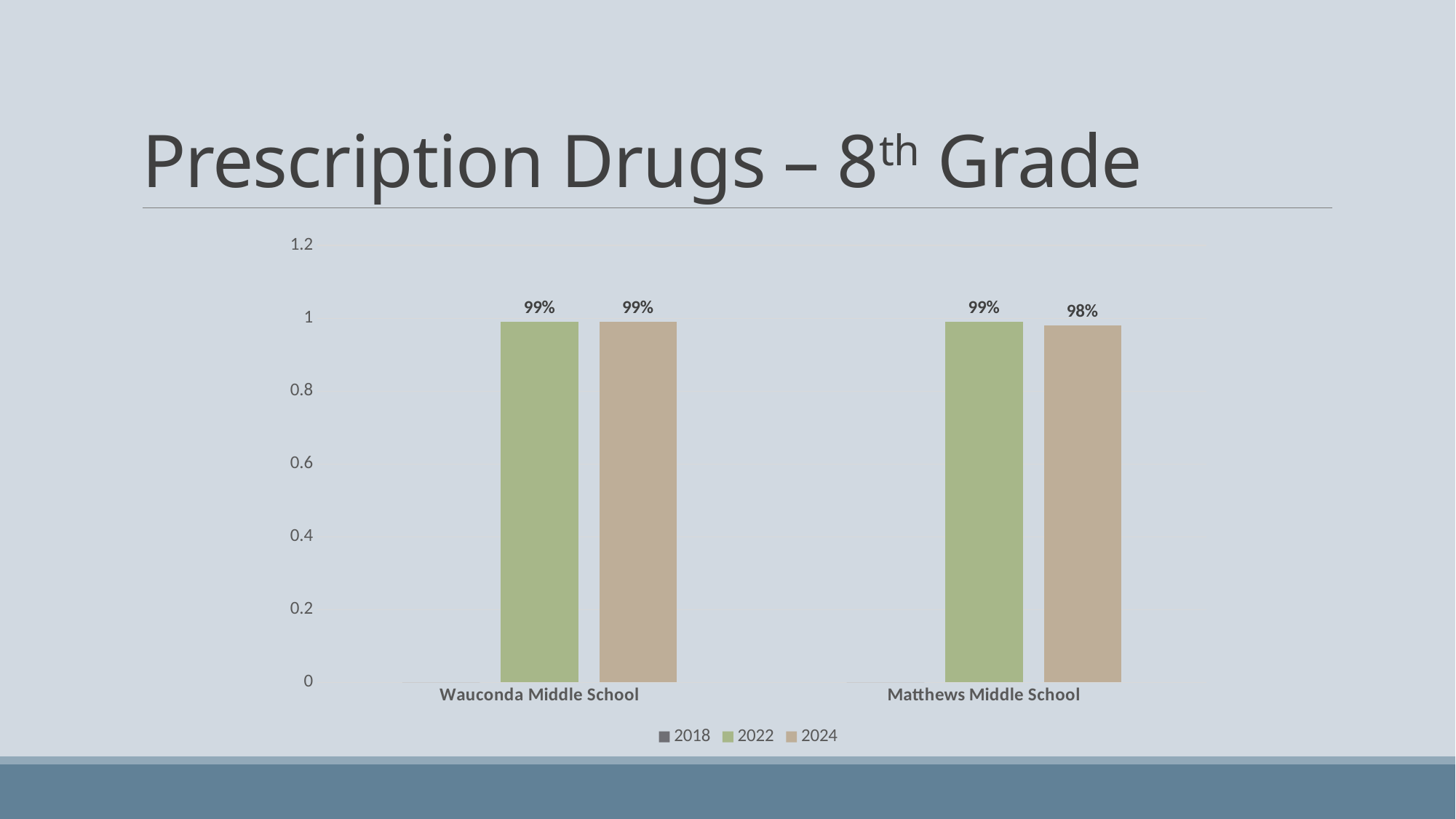
How many series does the legend list? 3 What is the 2024 value for Wauconda Middle School? 99% What kind of chart is shown on the slide? Bar chart Does the value for Matthews Middle School rise or fall from 2022 to 2024? fall Which years are listed in the legend? 2018, 2022, 2024 Is the 2024 value for Matthews Middle School greater or less than 0.8? greater What is the 2022 value for Wauconda Middle School? 99% What is the difference between the 2022 and 2024 values for Matthews Middle School? 1% How many schools are shown on the x axis? 2 What is the 2022 value for Matthews Middle School? 99% What is the title of the slide? Prescription Drugs – 8th Grade What is the 2024 value for Matthews Middle School? 98%